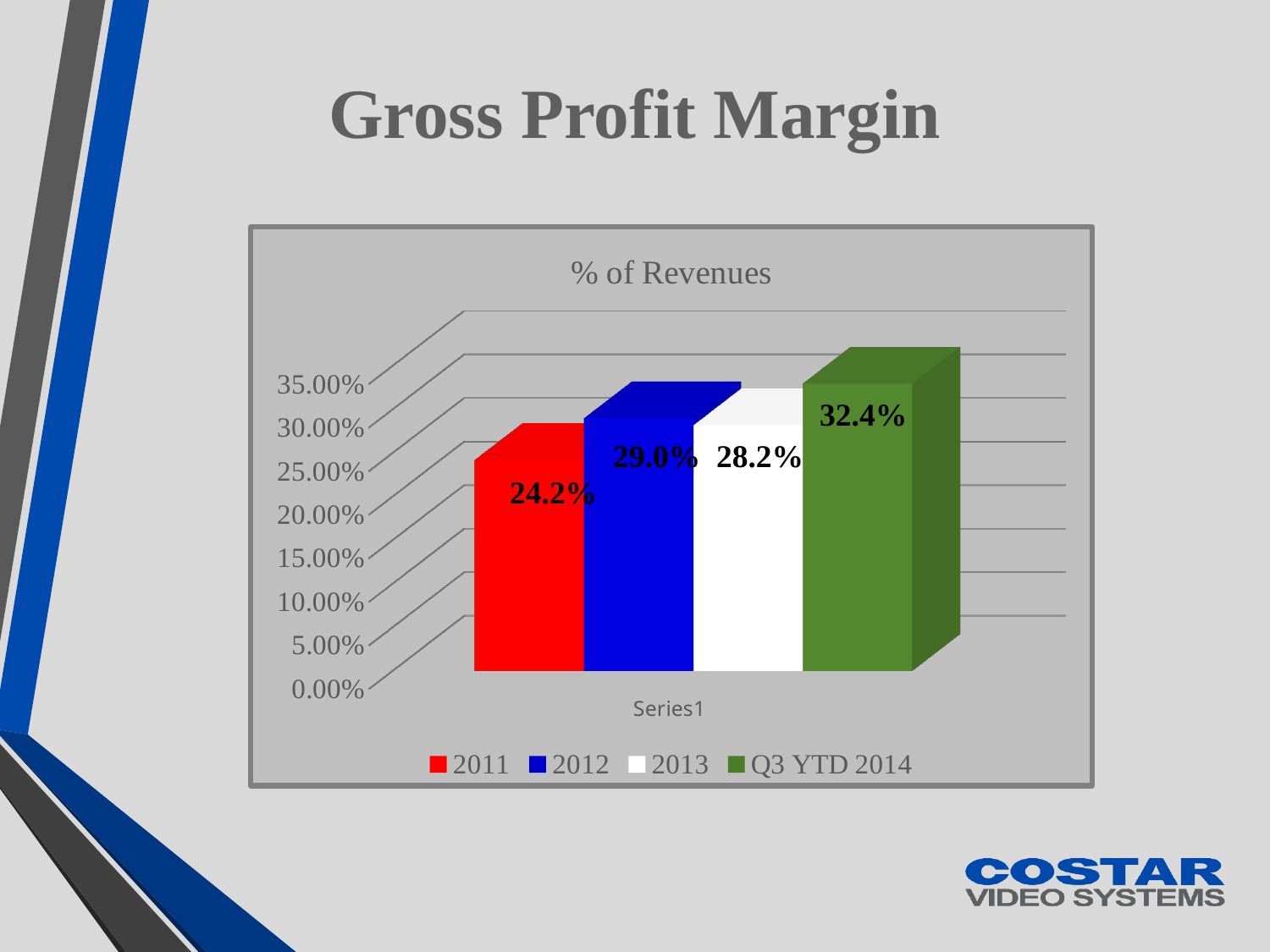
What is the title of the chart? % of Revenues What is the gross profit margin for 2011? 24.2% What is the difference in gross profit margin between Q3 YTD 2014 and 2011? 8.2% How many series does the legend list? 4 Which period has the highest gross profit margin? Q3 YTD 2014 What colour is the bar for 2013? White What is the gross profit margin for 2012? 29.0% What is the gross profit margin for Q3 YTD 2014? 32.4% What kind of chart is shown on the slide? Bar chart Which period has the lowest gross profit margin? 2011 What is the gross profit margin for 2013? 28.2% Which has a higher gross profit margin, 2012 or 2013? 2012